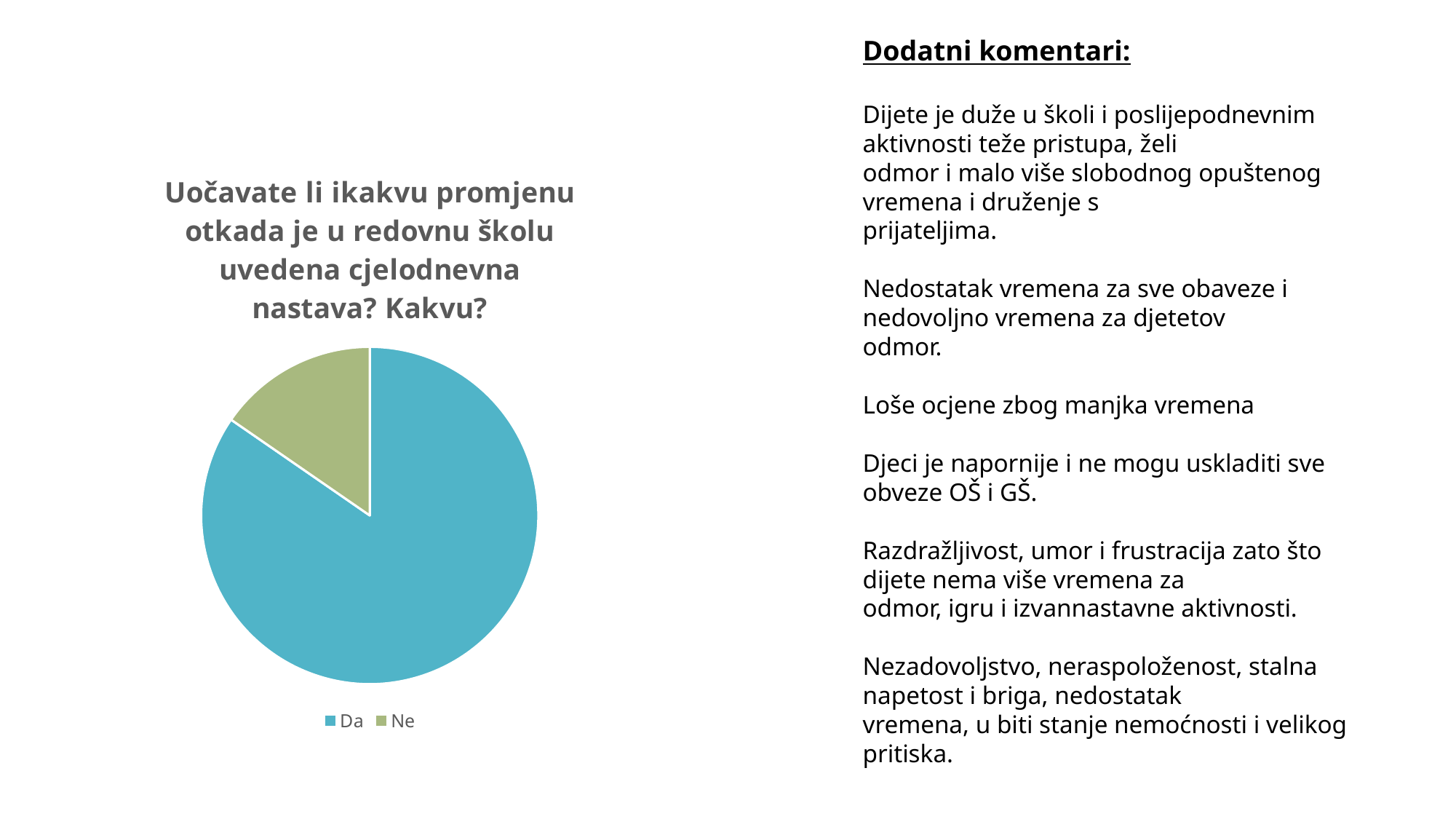
How many entries does the legend of the pie chart list? 2 What colour is the Ne slice in the pie chart? green How many slices does the pie chart have? 2 Which slice is larger in the pie chart, Da or Ne? Da Which category has the largest slice in the pie chart? Da What kind of chart is shown on the slide? pie chart What is the title of the pie chart? Uočavate li ikakvu promjenu otkada je u redovnu školu uvedena cjelodnevna nastava? Kakvu? Which category has the smallest slice in the pie chart? Ne